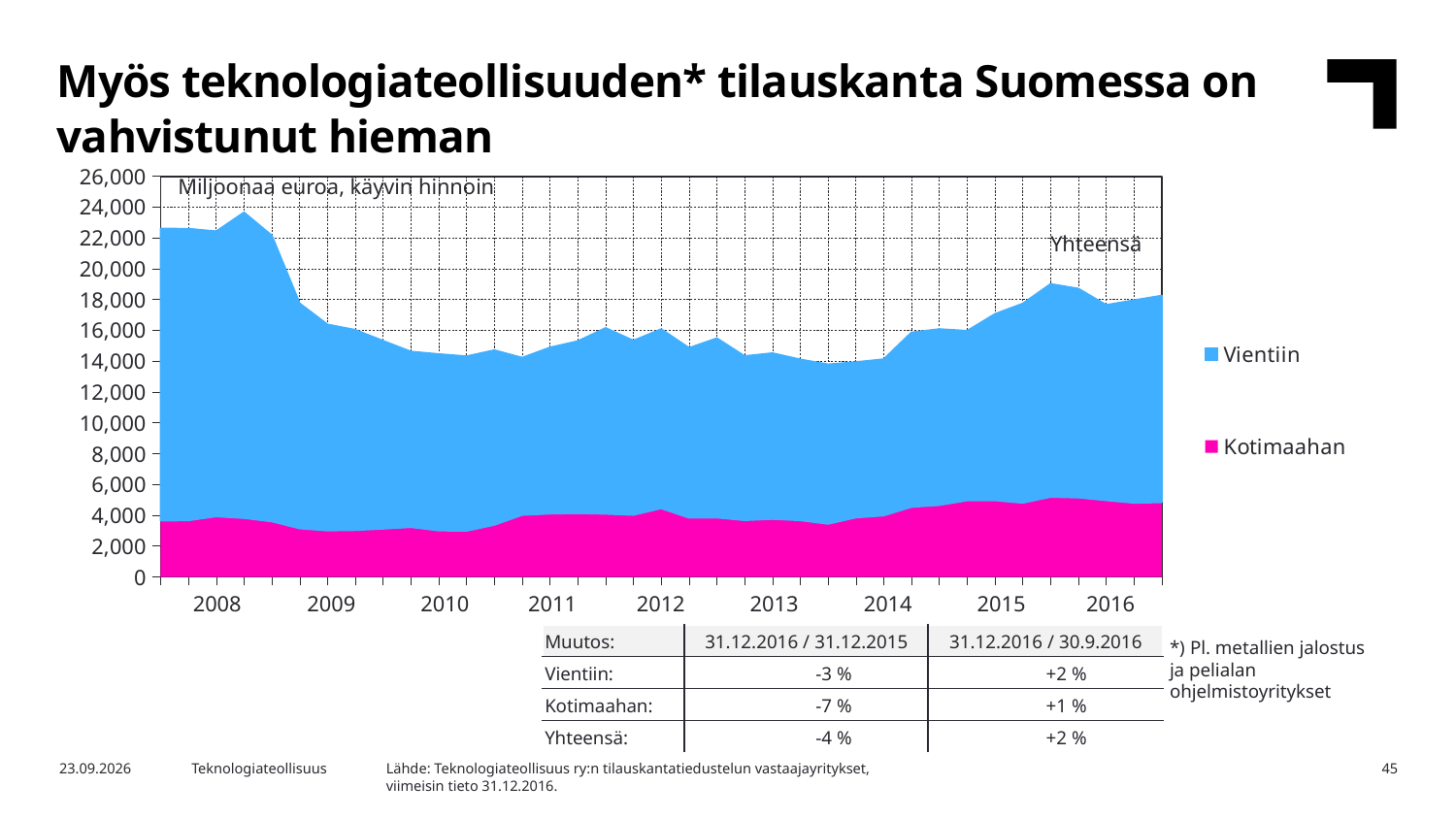
Is the total (Yhteensä) value at the end of 2016 greater or less than 20,000? less What unit label is printed inside the chart area? Miljoonaa euroa, käyvin hinnoin Is the Kotimaahan value in 2010 greater or less than 4,000? less In which year does the total (Yhteensä) reach its highest level on the chart? 2008 What kind of chart is shown on the slide? Area chart Is the Kotimaahan value at the end of 2016 greater or less than 4,000? greater Does the total order book (Yhteensä) rise or fall between 2008 and 2010? fall What are the two series named in the chart legend? Vientiin and Kotimaahan Which series, Vientiin or Kotimaahan, has the larger values throughout the chart? Vientiin How many years are labelled on the x axis of the chart? 9 How many series does the chart legend list? 2